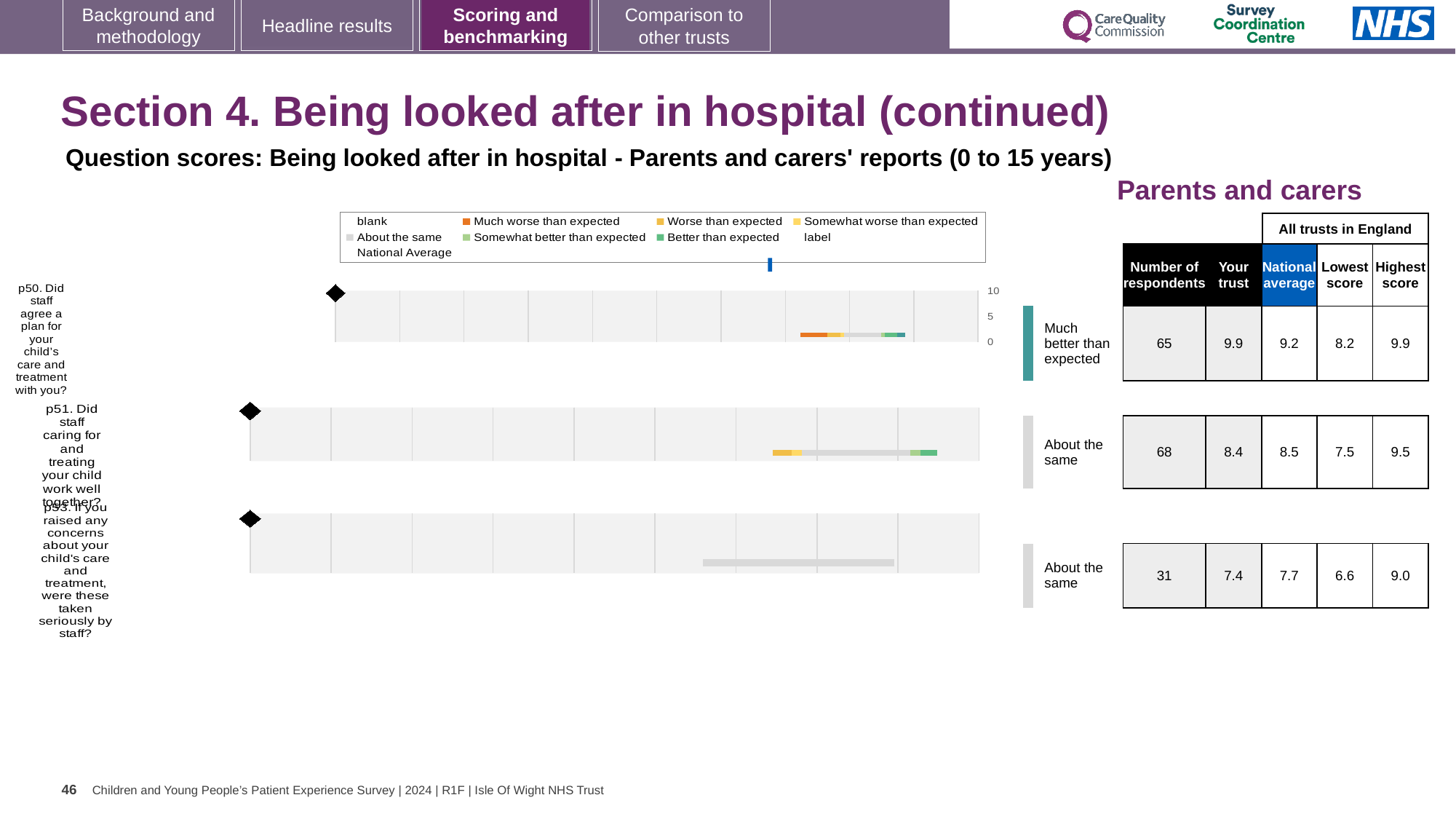
Which question has the fewest respondents? p53 Which question has the highest 'Your trust' score? p50 What is the national average score for p53 (were concerns taken seriously by staff?)? 7.7 Which is larger, the 'Your trust' score for p50 or for p53? p50 What benchmark category is shown for p50? Much better than expected How many respondents are shown for p50 (Did staff agree a plan for your child's care and treatment with you?)? 65 What is the difference between the national average and the 'Your trust' score for p51? 0.1 What is the lowest score among all trusts in England for p53? 6.6 What is the 'Your trust' score for p51 (Did staff caring for and treating your child work well together?)? 8.4 How many questions are charted on this slide? 3 What is the difference between the 'Your trust' score and the national average for p50? 0.7 What is the highest score among all trusts in England for p50? 9.9